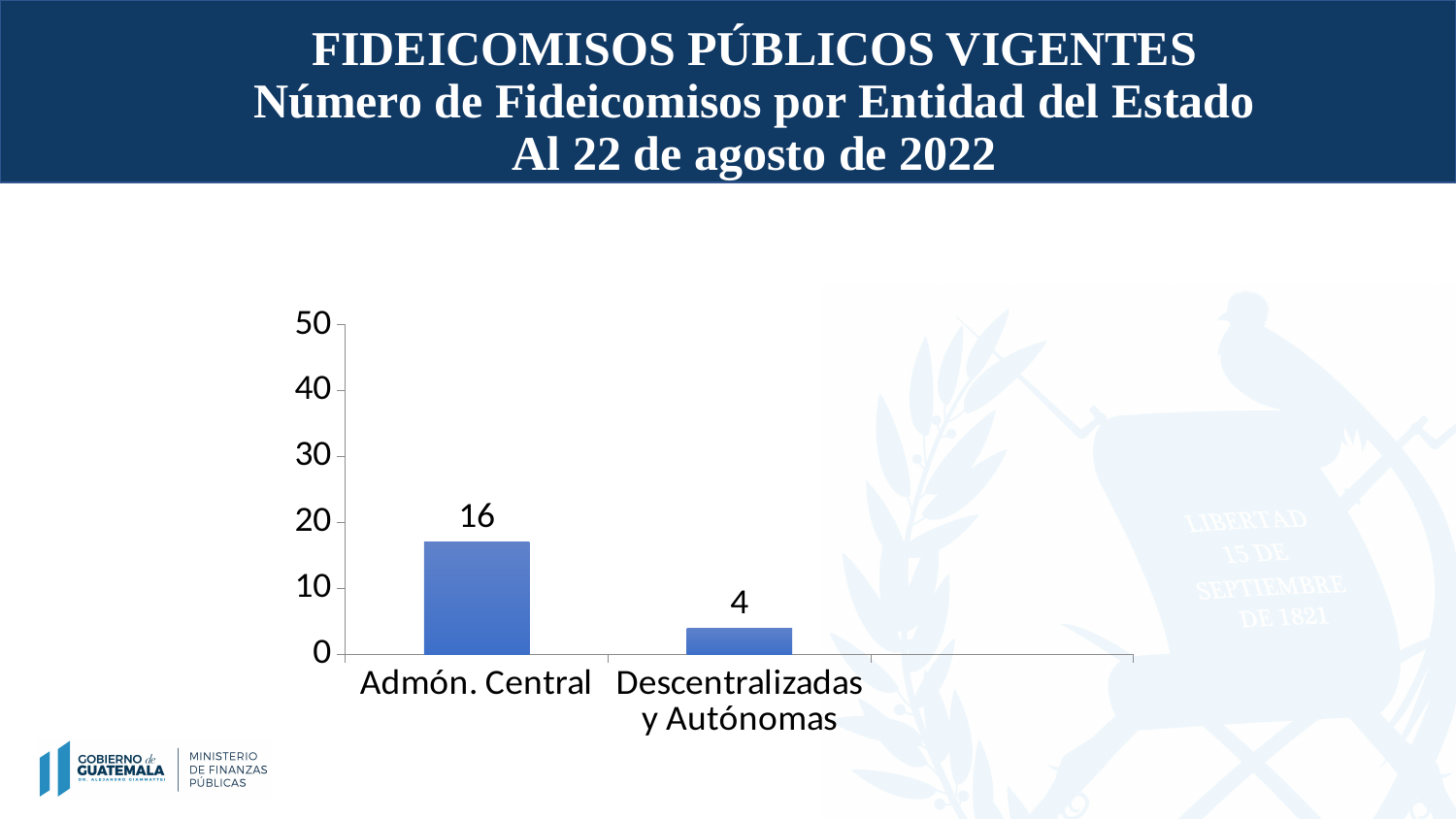
What is the value for Admón. Central? 16 Is the value for Descentralizadas y Autónomas greater or less than 10? less What is the value for Descentralizadas y Autónomas? 4 Which category has the highest value? Admón. Central Which category has the lowest value? Descentralizadas y Autónomas How many categories are shown on the x axis? 2 Is the value for Admón. Central greater or less than 20? less What kind of chart is shown on the slide? bar chart What is the difference between the values for Admón. Central and Descentralizadas y Autónomas? 12 Do the values rise or fall from left to right along the x axis? fall Which is larger, the value for Admón. Central or the value for Descentralizadas y Autónomas? Admón. Central What is the highest value shown on the y axis? 50